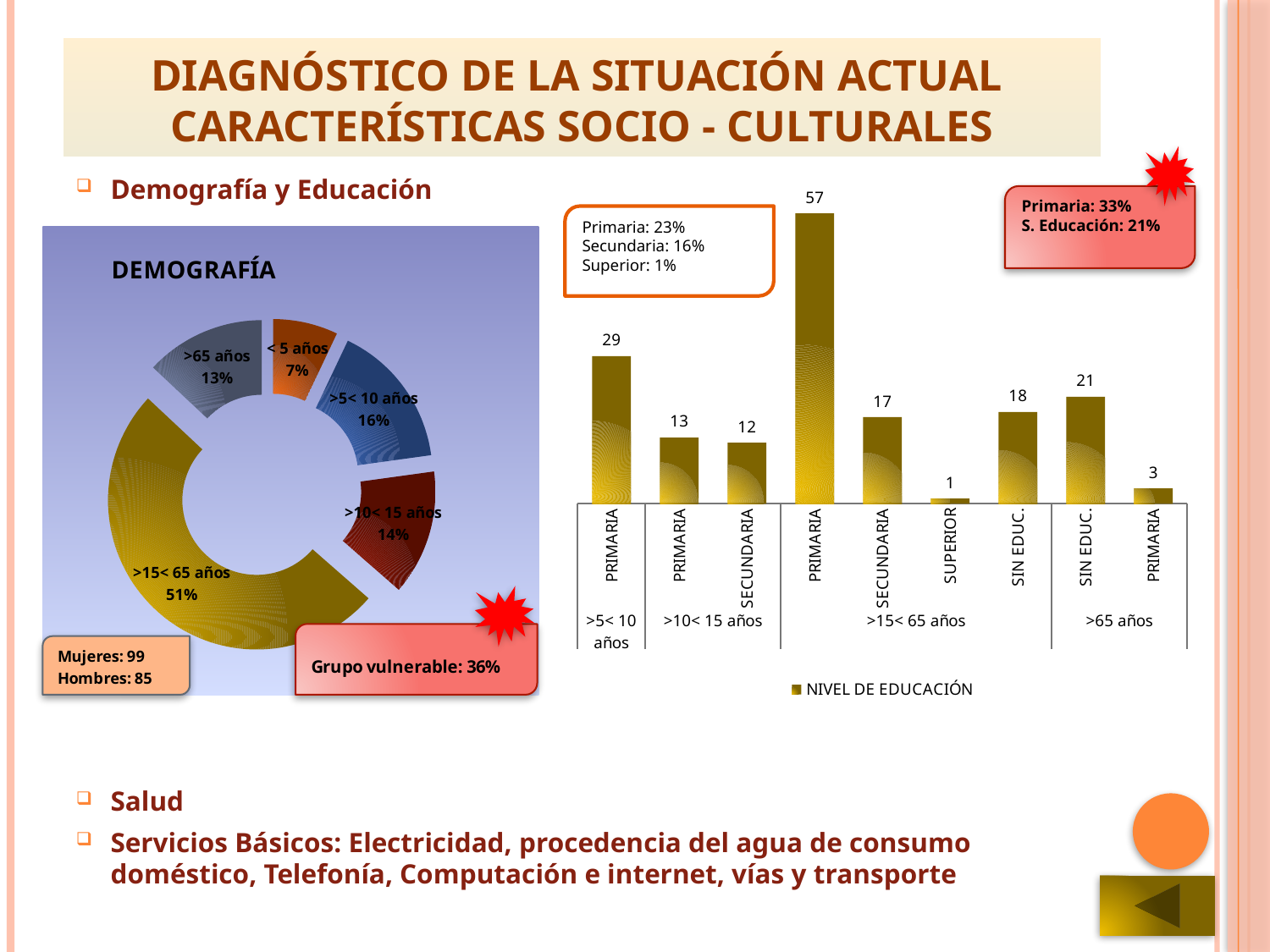
In the DEMOGRAFÍA chart, which age group has the smallest share? < 5 años In the NIVEL DE EDUCACIÓN bar chart, which bar has the lowest value? SUPERIOR (>15< 65 años) In the DEMOGRAFÍA chart, which is larger: the >5< 10 años slice or the >65 años slice? >5< 10 años In the DEMOGRAFÍA chart, what share of the population is in the >15< 65 años group? 51% In the DEMOGRAFÍA chart, what percentage is shown for the < 5 años slice? 7% In the NIVEL DE EDUCACIÓN bar chart, how many bars are plotted? 9 What type of chart is the NIVEL DE EDUCACIÓN chart? Bar chart In the NIVEL DE EDUCACIÓN bar chart, what is the value for SIN EDUC. in the >65 años group? 21 In the DEMOGRAFÍA chart, which age group has the largest share? >15< 65 años In the DEMOGRAFÍA chart, how many age-group slices are there? 5 In the NIVEL DE EDUCACIÓN bar chart, what is the difference between PRIMARIA and SECUNDARIA in the >10< 15 años group? 1 In the NIVEL DE EDUCACIÓN bar chart, what is the value for PRIMARIA in the >15< 65 años group? 57